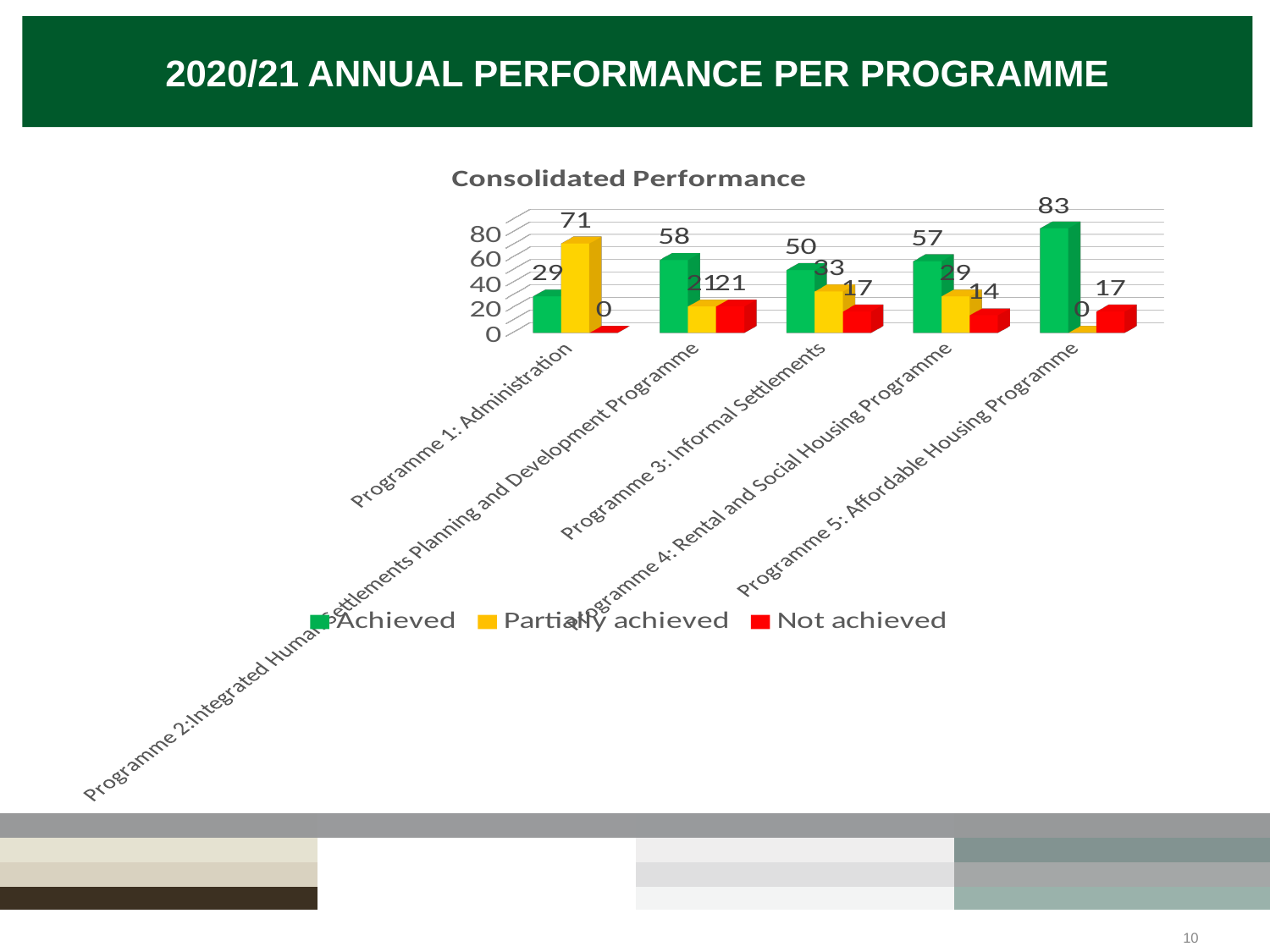
What is the Partially achieved value for Programme 1: Administration? 71 Which programme has the lowest Achieved value? Programme 1: Administration Which programme has the highest Achieved value? Programme 5: Affordable Housing Programme What is the Achieved value for Programme 1: Administration? 29 How many series does the legend list? 3 What is the Not achieved value for Programme 3: Informal Settlements? 17 What is the Partially achieved value for Programme 4: Rental and Social Housing Programme? 29 What is the Achieved value for Programme 5: Affordable Housing Programme? 83 How many programmes are shown on the x axis? 5 Which is larger, the Achieved value for Programme 3: Informal Settlements or for Programme 4: Rental and Social Housing Programme? Programme 4: Rental and Social Housing Programme What is the difference between the Achieved values for Programme 5: Affordable Housing Programme and Programme 1: Administration? 54 What type of chart is shown? Bar chart